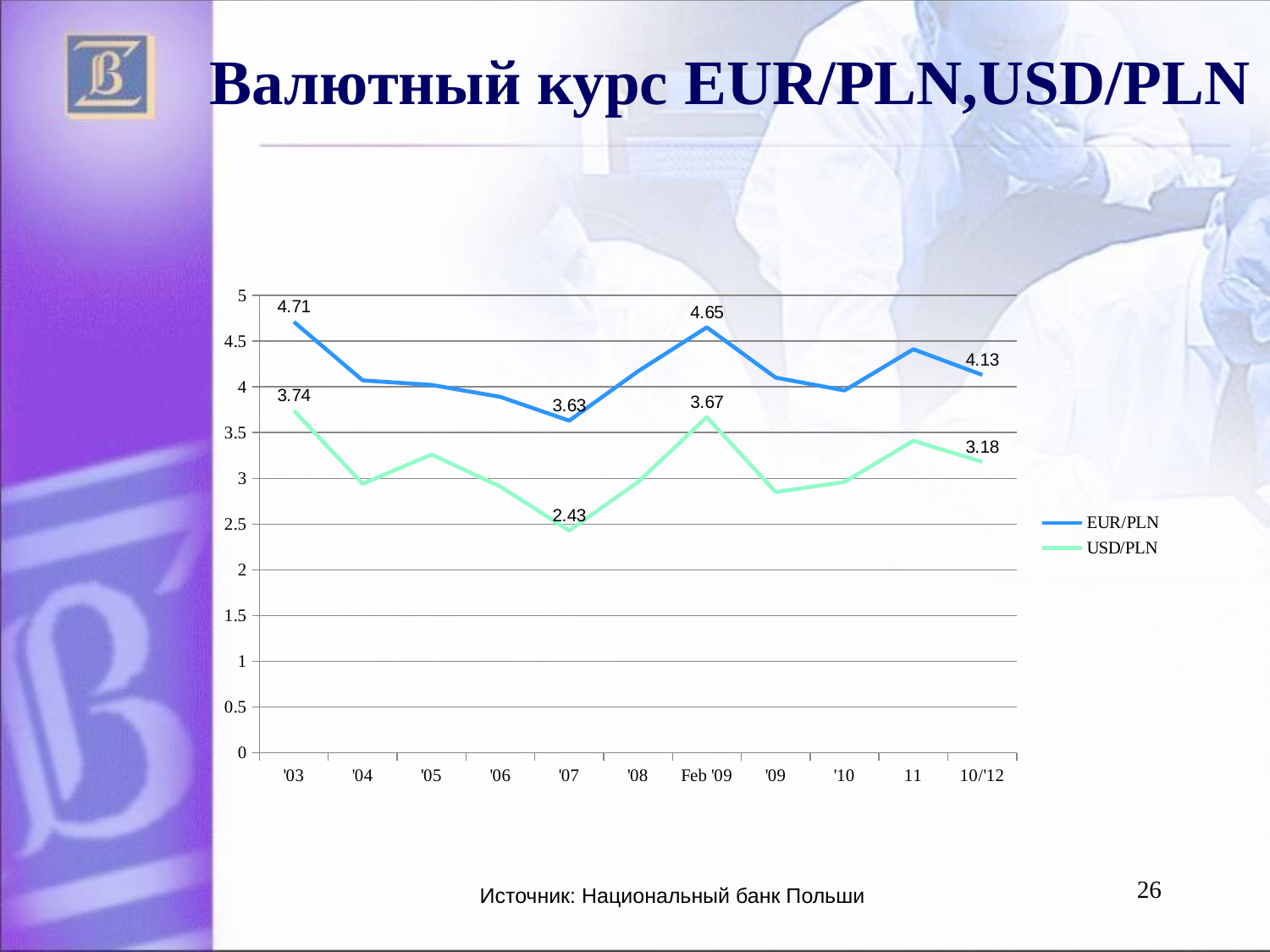
At which x-axis point does USD/PLN reach its lowest labelled value? '07 What is the EUR/PLN value for '03? 4.71 How many series does the legend list? 2 What is the EUR/PLN value for Feb '09? 4.65 What is the difference between the EUR/PLN and USD/PLN values for '03? 0.97 What is the USD/PLN value for '07? 2.43 What is the USD/PLN value for 10/'12? 3.18 What type of chart is shown on the slide? line chart How many points are on the x axis? 11 What is the difference between the EUR/PLN values for '03 and '07? 1.08 Which series has the higher value at Feb '09, EUR/PLN or USD/PLN? EUR/PLN